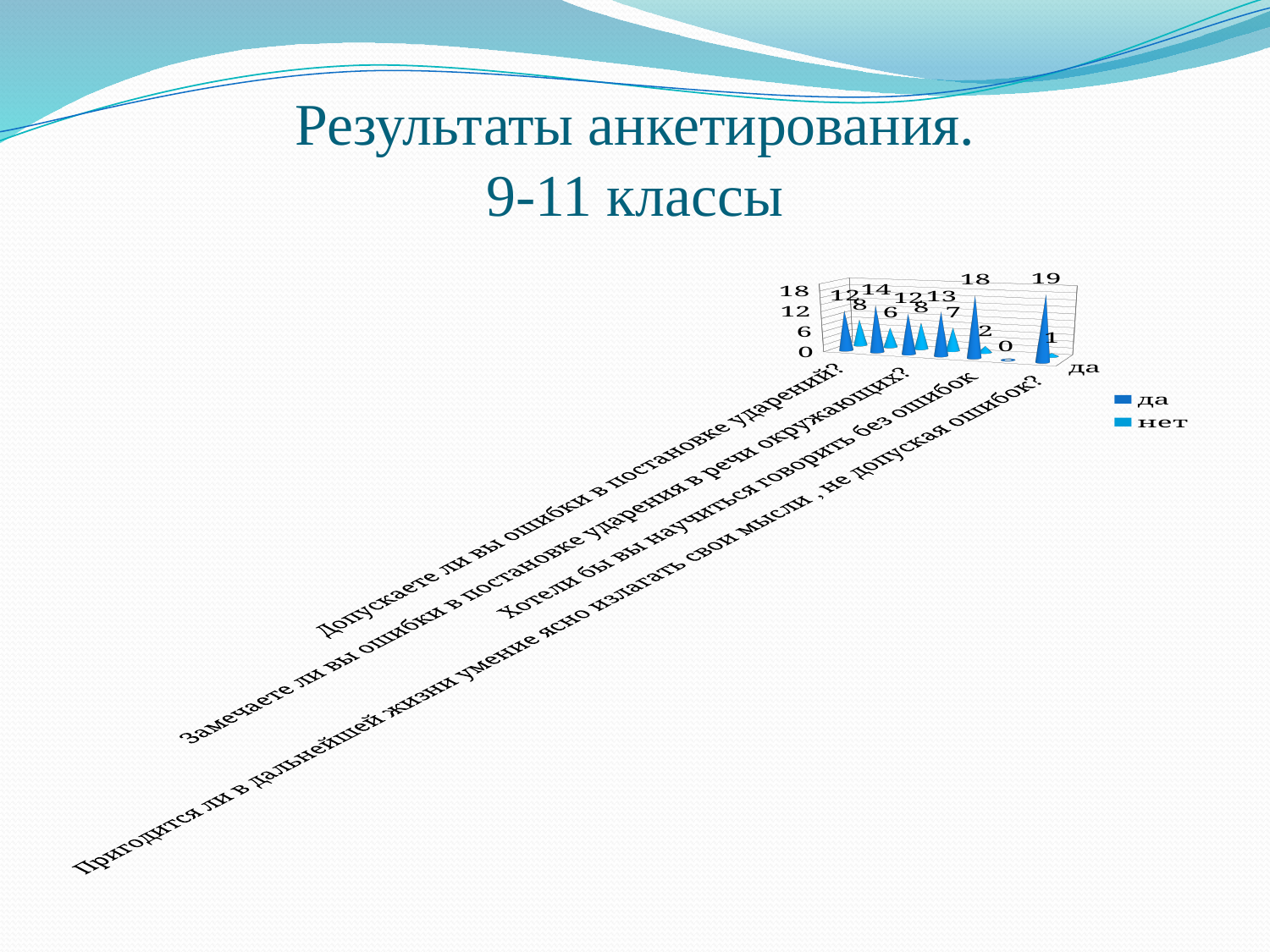
What is the title of the slide containing the chart? Результаты анкетирования. 9-11 классы Is the highest value on the chart greater or less than 18? greater What is the lowest data label value shown on the chart? 0 What are the two series named in the chart legend? да, нет How many series does the chart legend list? 2 Which series, да or нет, has the larger value in the last category on the chart? да What is the highest data label value shown on the chart? 19 What is the maximum value shown on the chart's vertical axis? 18